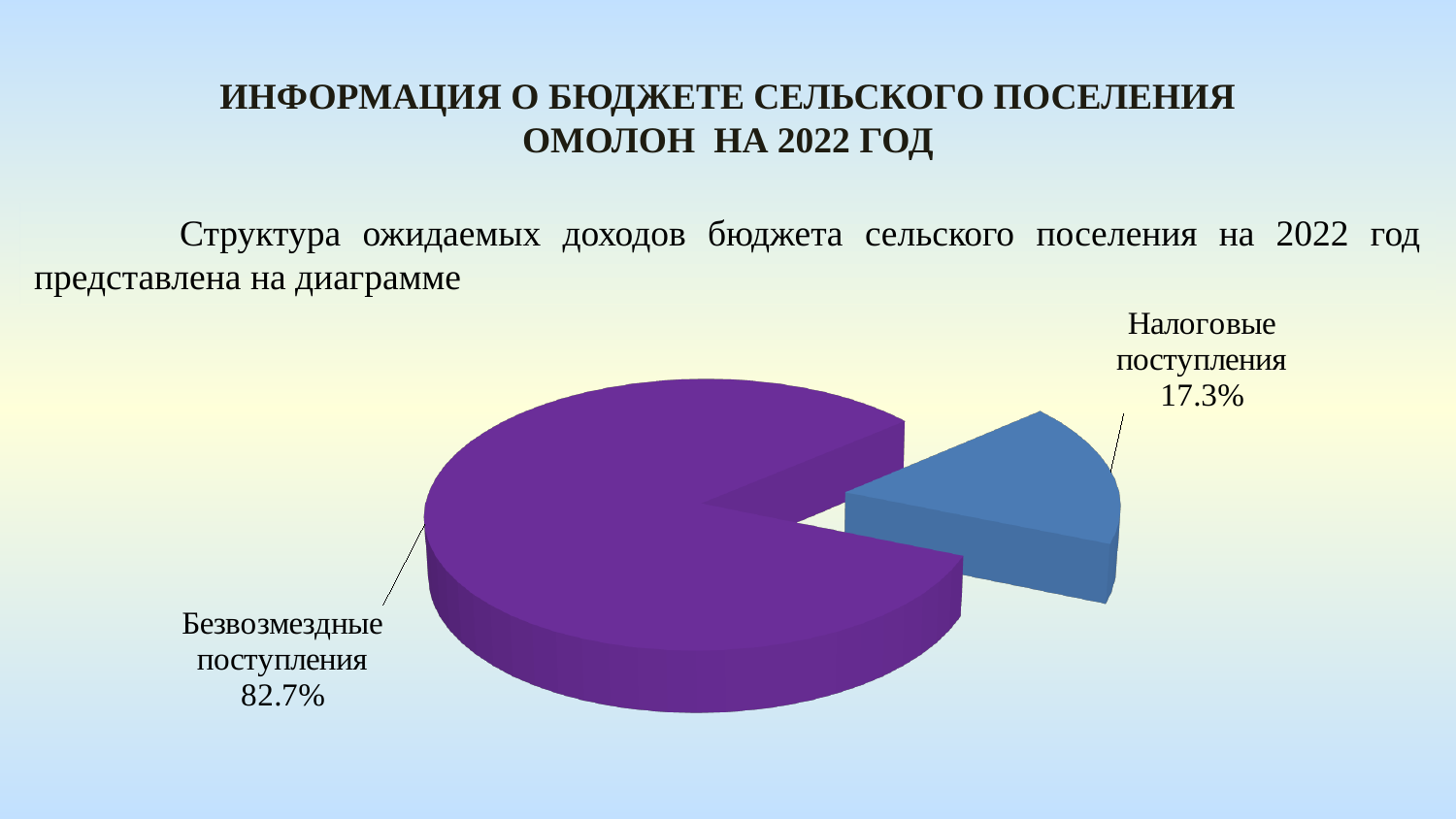
What share of the pie is labelled "Налоговые поступления"? 17.3% How many slices does the pie chart have? 2 What share of the pie is labelled "Безвозмездные поступления"? 82.7% What colour is the "Безвозмездные поступления" slice? Purple Which slice of the pie is the largest? Безвозмездные поступления Which slice of the pie is the smallest? Налоговые поступления What is the difference in percentage points between the "Безвозмездные поступления" and "Налоговые поступления" slices? 65.4 What colour is the "Налоговые поступления" slice? Blue What kind of chart is shown on the slide? Pie chart What is the total of the two slice percentages shown on the pie chart? 100% Which is larger: "Налоговые поступления" or "Безвозмездные поступления"? Безвозмездные поступления